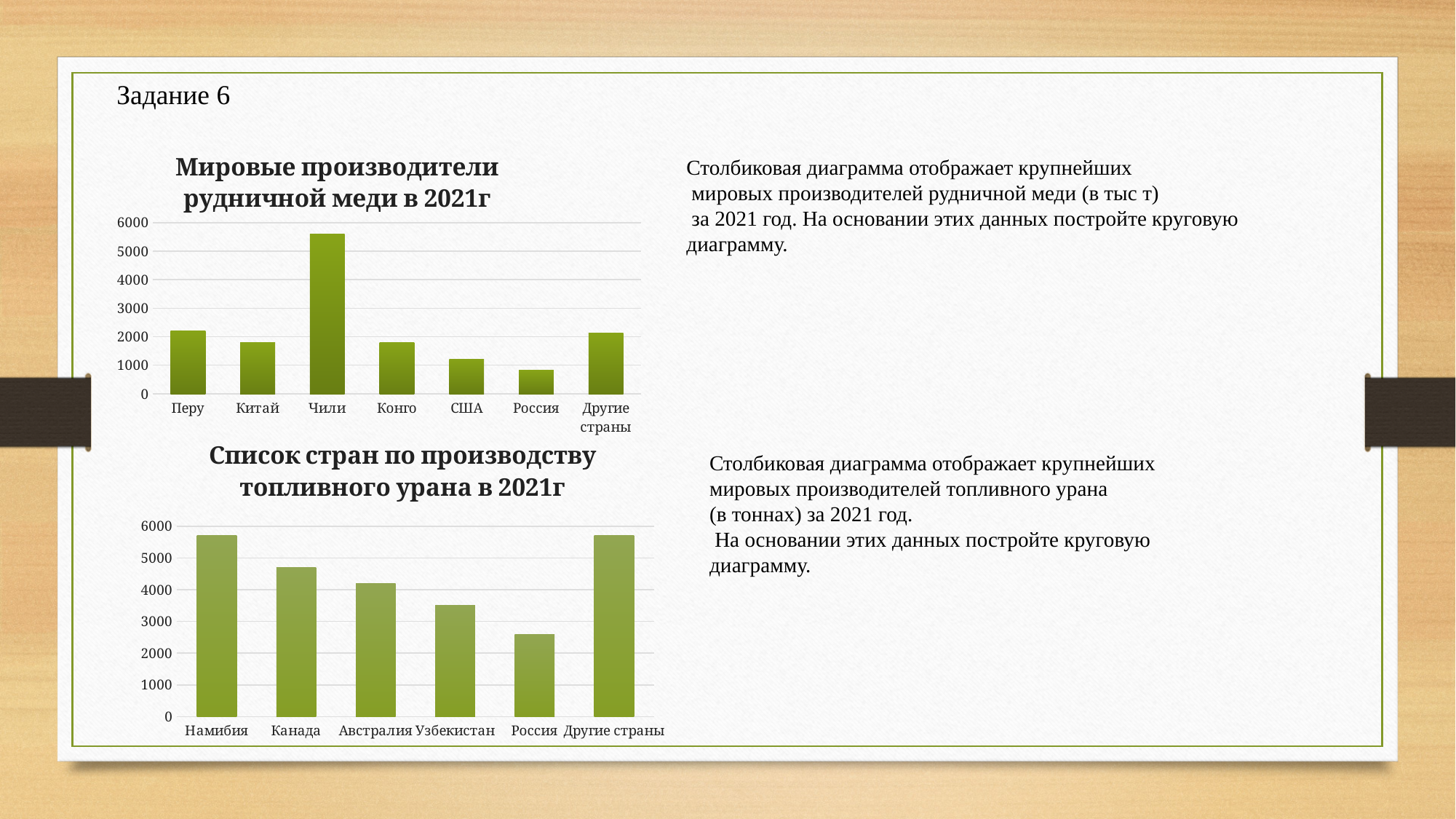
In the chart 'Список стран по производству топливного урана в 2021г', which category has the lowest value? Россия In the chart 'Мировые производители рудничной меди в 2021г', how many categories are shown on the x axis? 7 In the chart 'Список стран по производству топливного урана в 2021г', is the value for Канада greater or less than 5000? less In the chart 'Список стран по производству топливного урана в 2021г', is the value for Узбекистан greater or less than 3000? greater In the chart 'Мировые производители рудничной меди в 2021г', is the value for США greater or less than 1000? greater In the chart 'Список стран по производству топливного урана в 2021г', how many categories are shown on the x axis? 6 In the chart 'Мировые производители рудничной меди в 2021г', which category has the lowest value? Россия What type of chart is 'Список стран по производству топливного урана в 2021г'? bar chart In the chart 'Мировые производители рудничной меди в 2021г', which is larger, the value for Перу or the value for США? Перу In the chart 'Мировые производители рудничной меди в 2021г', which country has the highest value? Чили